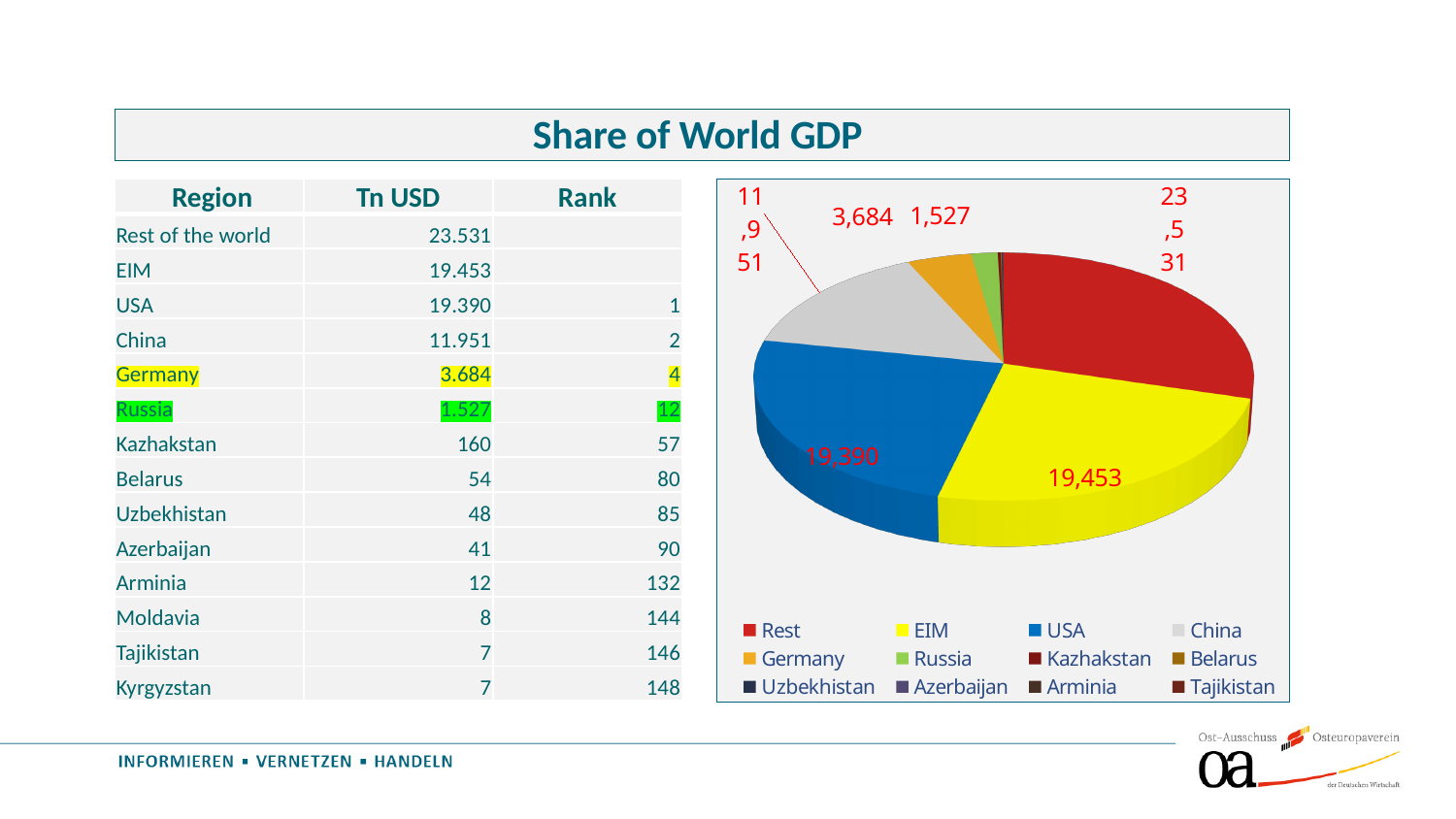
What value is labelled on the Germany slice of the pie chart? 3,684 What value is labelled on the EIM slice of the pie chart? 19,453 Which slice is larger in the pie chart, Germany or Russia? Germany What is the difference between the labelled values for EIM and USA in the pie chart? 63 What is the title of the chart? Share of World GDP What colour is the Rest slice in the pie chart? red What value is labelled on the USA slice of the pie chart? 19,390 What value is labelled on the Russia slice of the pie chart? 1,527 What is the difference between the labelled values for Germany and Russia in the pie chart? 2,157 How many entries does the chart's legend list? 12 What kind of chart is shown on the slide? pie chart Which category has the largest slice in the pie chart? Rest